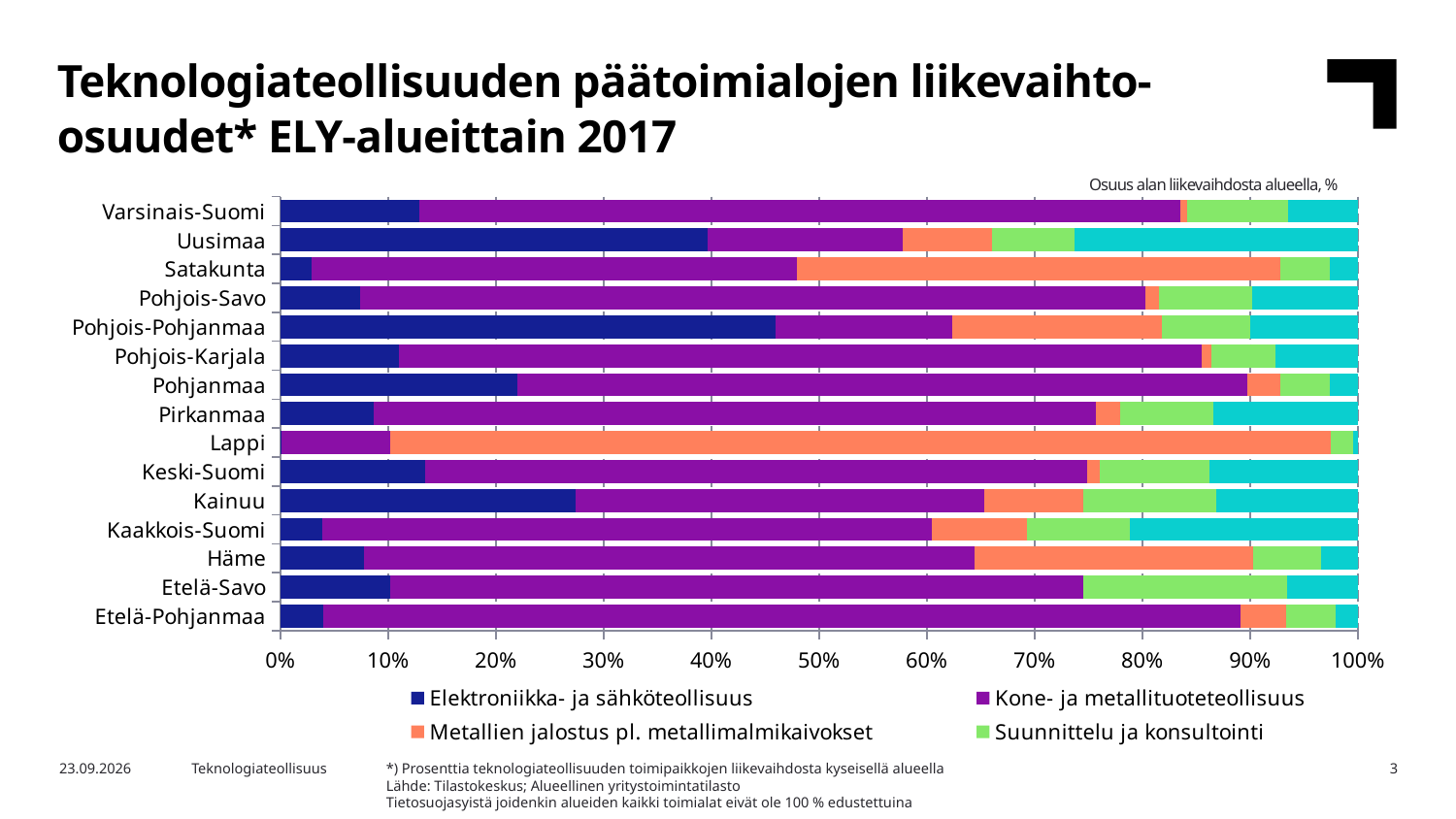
What kind of chart is shown on the slide? Stacked bar chart Is the Elektroniikka- ja sähköteollisuus share for Uusimaa greater or less than 30%? greater Which region has the larger Elektroniikka- ja sähköteollisuus share, Uusimaa or Satakunta? Uusimaa Is the Elektroniikka- ja sähköteollisuus share for Kainuu greater or less than 20%? greater How many ELY regions are listed on the vertical axis of the chart? 15 Is the Metallien jalostus pl. metallimalmikaivokset share for Lappi greater or less than 80%? greater Which region has the larger Metallien jalostus pl. metallimalmikaivokset share, Satakunta or Pohjanmaa? Satakunta Which region has the largest share for Elektroniikka- ja sähköteollisuus? Pohjois-Pohjanmaa Which region has the largest share for Metallien jalostus pl. metallimalmikaivokset? Lappi What is the title of the chart on the slide? Teknologiateollisuuden päätoimialojen liikevaihto-osuudet* ELY-alueittain 2017 How many series does the chart legend list? 4